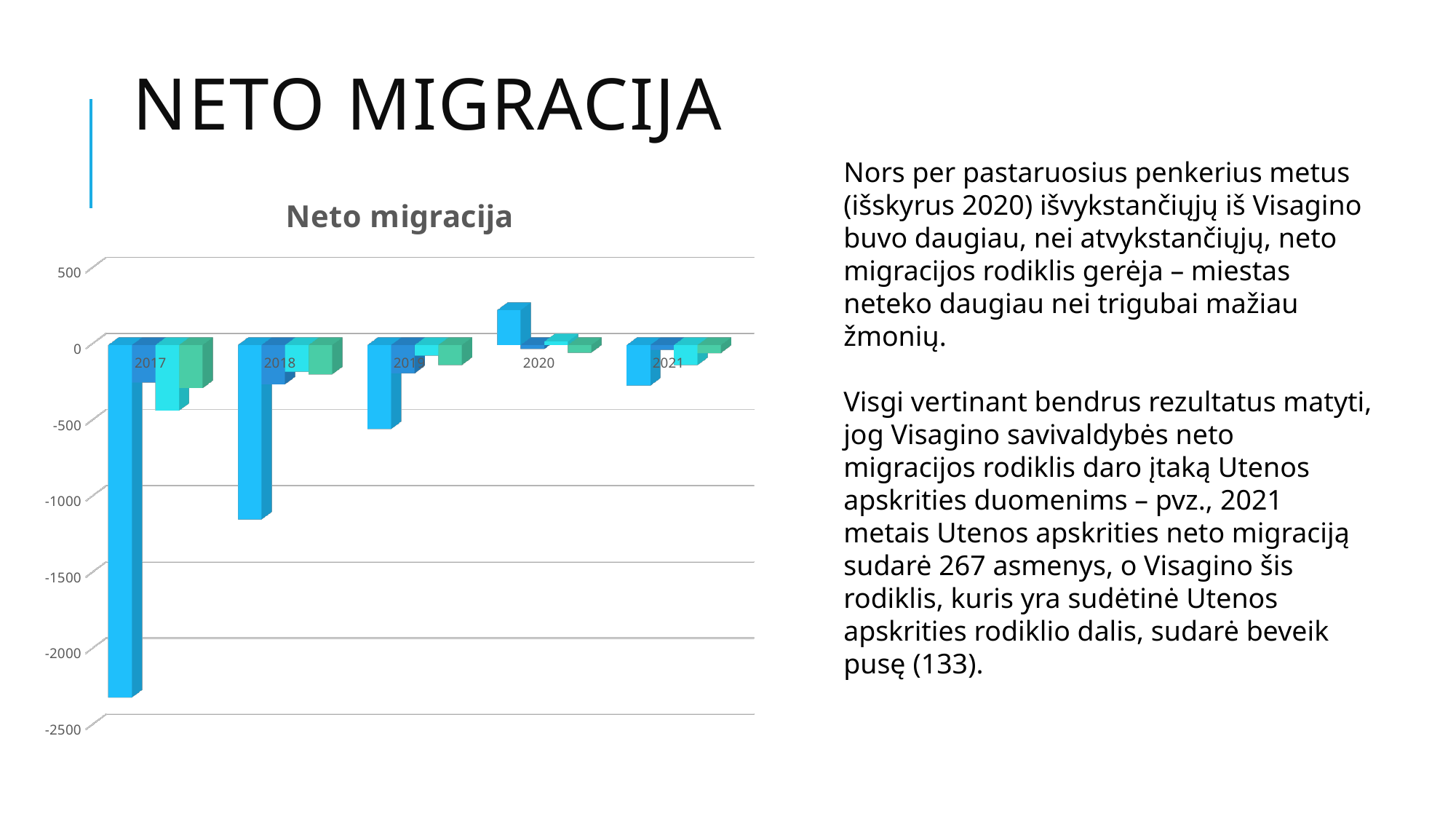
Which year has the lowest (most negative) leftmost bar? 2017 What is the title of the chart? Neto migracija Which year has the highest leftmost bar? 2020 Is the value of the tallest (leftmost, dark blue) bar for 2017 greater or less than -2000? less How many years are shown on the x axis of the chart? 5 Is the value of the leftmost bar for 2018 greater or less than -1000? less How many bars are plotted for each year in the chart? 4 Is the value of the leftmost bar for 2019 greater or less than -1000? greater Do the values of the leftmost bars rise or fall from 2017 to 2020? rise What kind of chart is shown on the slide? bar chart Which year has the larger value for the leftmost bar, 2017 or 2018? 2018